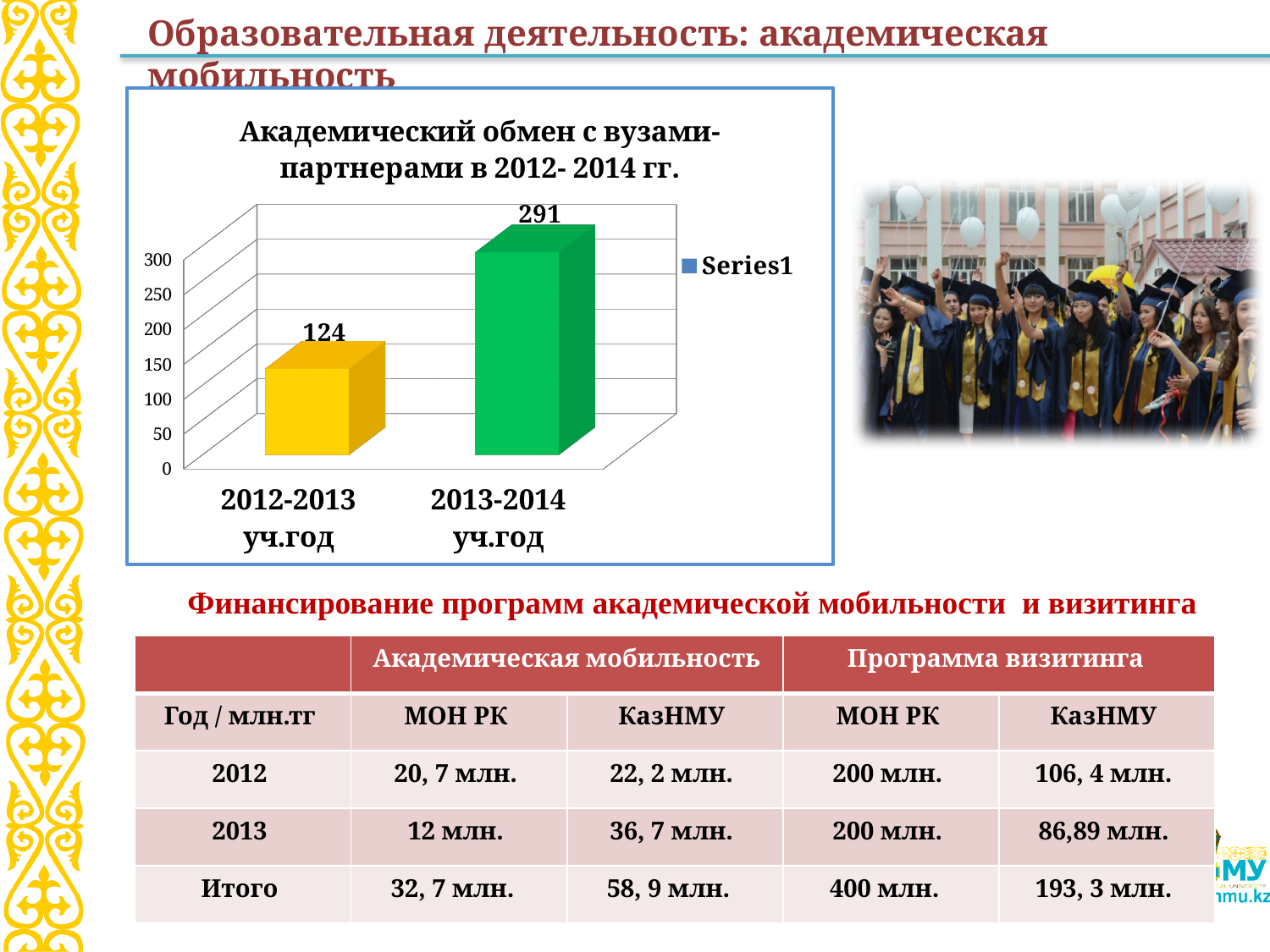
Is the value for 2012-2013 уч.год greater or less than 150? less How many series does the chart legend list? 1 How many categories are shown in the chart? 2 Which category has the highest value in the chart? 2013-2014 уч.год What is the difference between the values for 2013-2014 уч.год and 2012-2013 уч.год? 167 Which category has the lowest value in the chart? 2012-2013 уч.год What is the title of the chart? Академический обмен с вузами-партнерами в 2012- 2014 гг. What kind of chart is shown on the slide? bar chart Which is larger: the value for 2012-2013 уч.год or the value for 2013-2014 уч.год? 2013-2014 уч.год What is the value for 2013-2014 уч.год in the chart? 291 What is the value for 2012-2013 уч.год in the chart? 124 Is the value for 2013-2014 уч.год greater or less than 250? greater